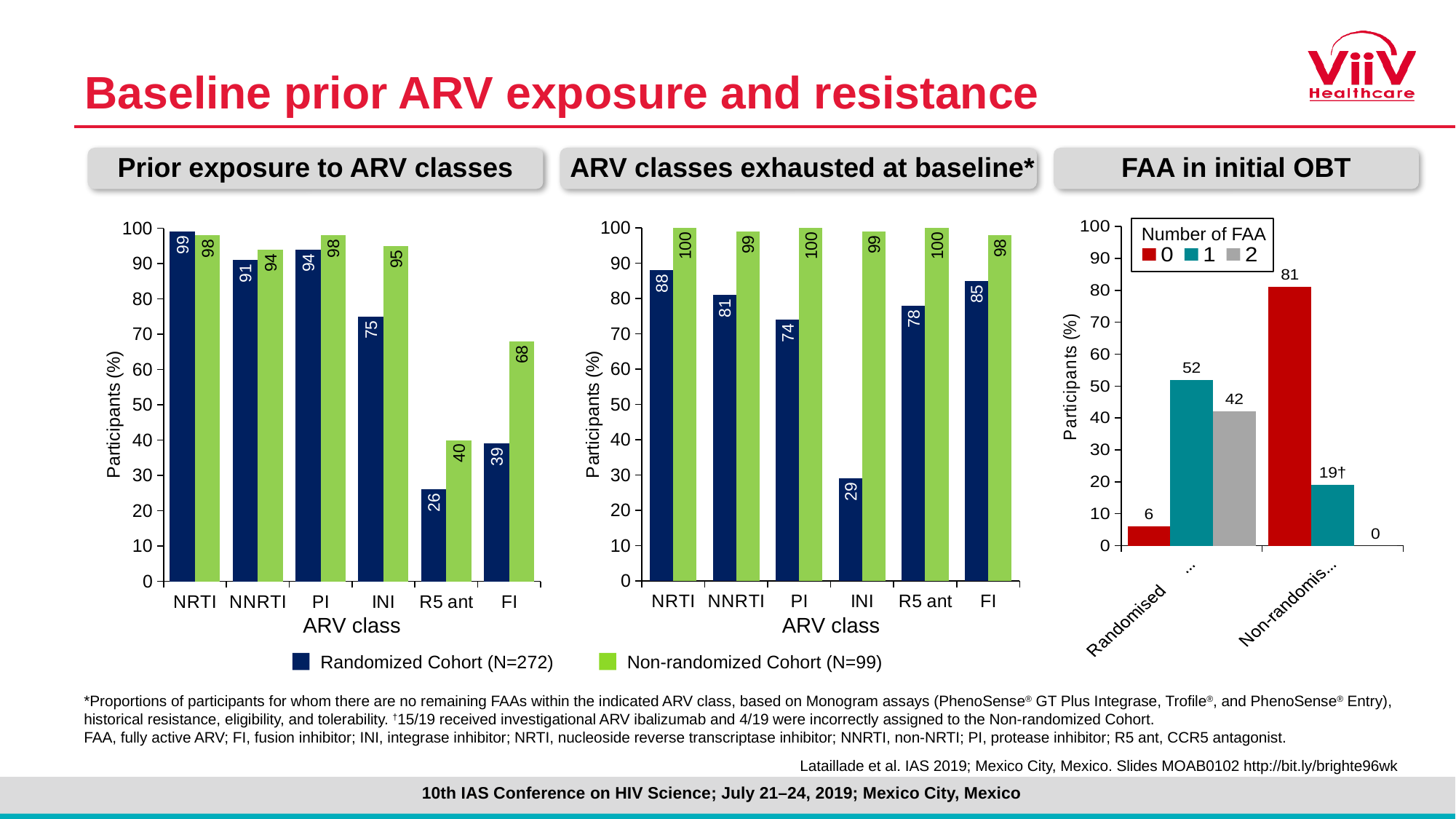
In the 'FAA in initial OBT' chart, which number of FAA has the highest value in the Non-randomised group? 0 In the 'ARV classes exhausted at baseline*' chart, what is the value for the Randomized Cohort for INI? 29 In the 'Prior exposure to ARV classes' chart, which ARV class has the lowest value for the Randomized Cohort? R5 ant In the 'FAA in initial OBT' chart, what is the value for 1 FAA in the Randomised group? 52 What kind of chart is the 'FAA in initial OBT' chart? bar chart In the 'Prior exposure to ARV classes' chart, how many ARV classes are shown on the x axis? 6 In the 'Prior exposure to ARV classes' chart, what is the value for the Randomized Cohort for INI? 75 In the 'FAA in initial OBT' chart, how many series does the legend list? 3 In the 'Prior exposure to ARV classes' chart, what is the difference between the Non-randomized and Randomized Cohort values for FI? 29 In the 'ARV classes exhausted at baseline*' chart, which ARV class has the highest value for the Randomized Cohort? NRTI In the 'ARV classes exhausted at baseline*' chart, is the Randomized Cohort value for PI larger or smaller than the Non-randomized Cohort value for PI? smaller In the 'ARV classes exhausted at baseline*' chart, what is the difference between the Non-randomized and Randomized Cohort values for NNRTI? 18